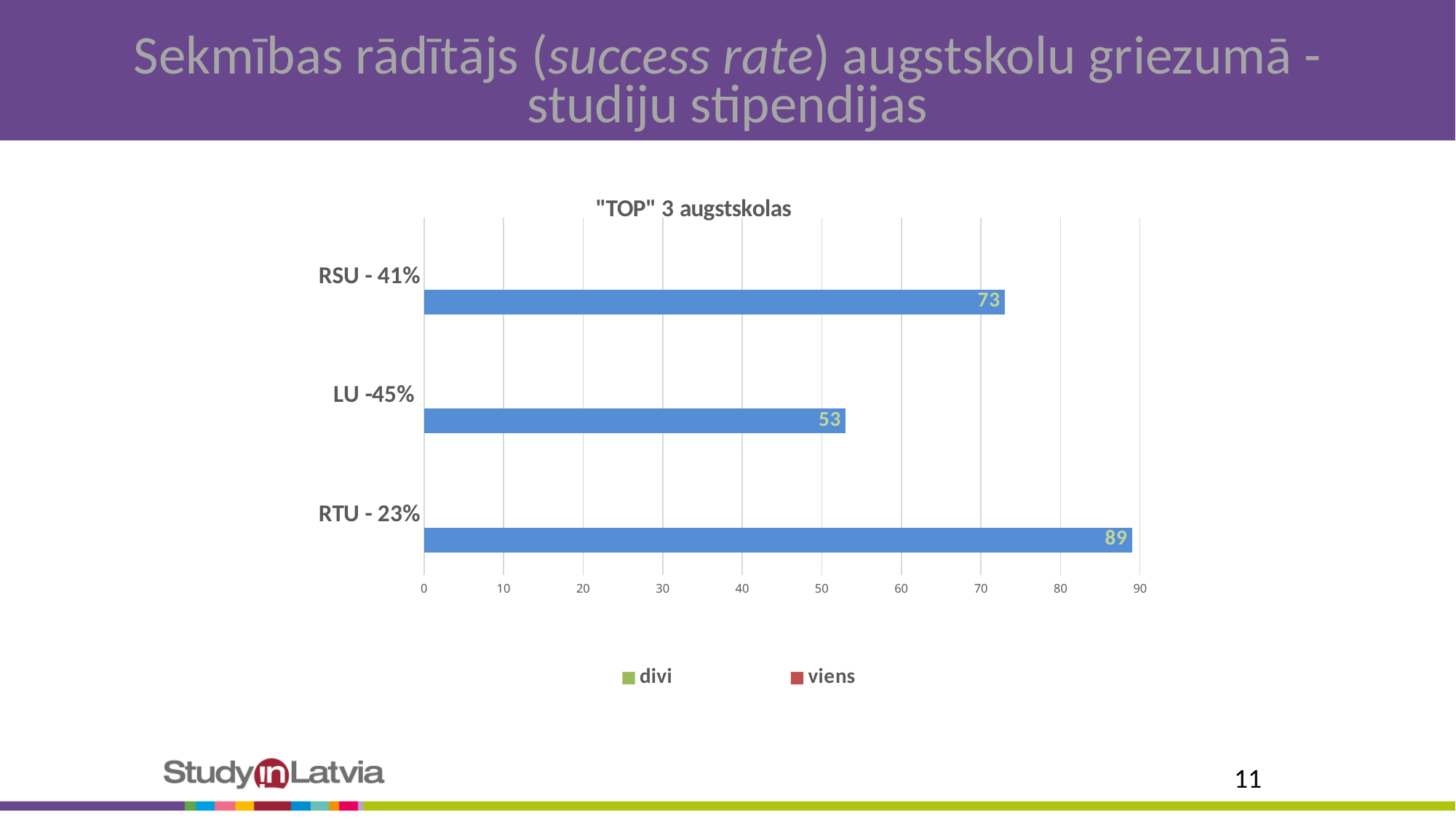
What is the value of the bar for RTU - 23%? 89 What is the difference between the bar values for RTU - 23% and LU -45%? 36 What is the value of the bar for RSU - 41%? 73 How many categories are shown on the chart? 3 What type of chart is shown on the slide? bar chart Which has a larger bar value, RSU - 41% or LU -45%? RSU - 41% How many entries does the chart legend list? 2 Which category has the highest bar value? RTU - 23% What is the value of the bar for LU -45%? 53 What is the difference between the bar values for RTU - 23% and RSU - 41%? 16 Is the bar value for LU -45% greater or less than 60? less Which category has the lowest bar value? LU -45%